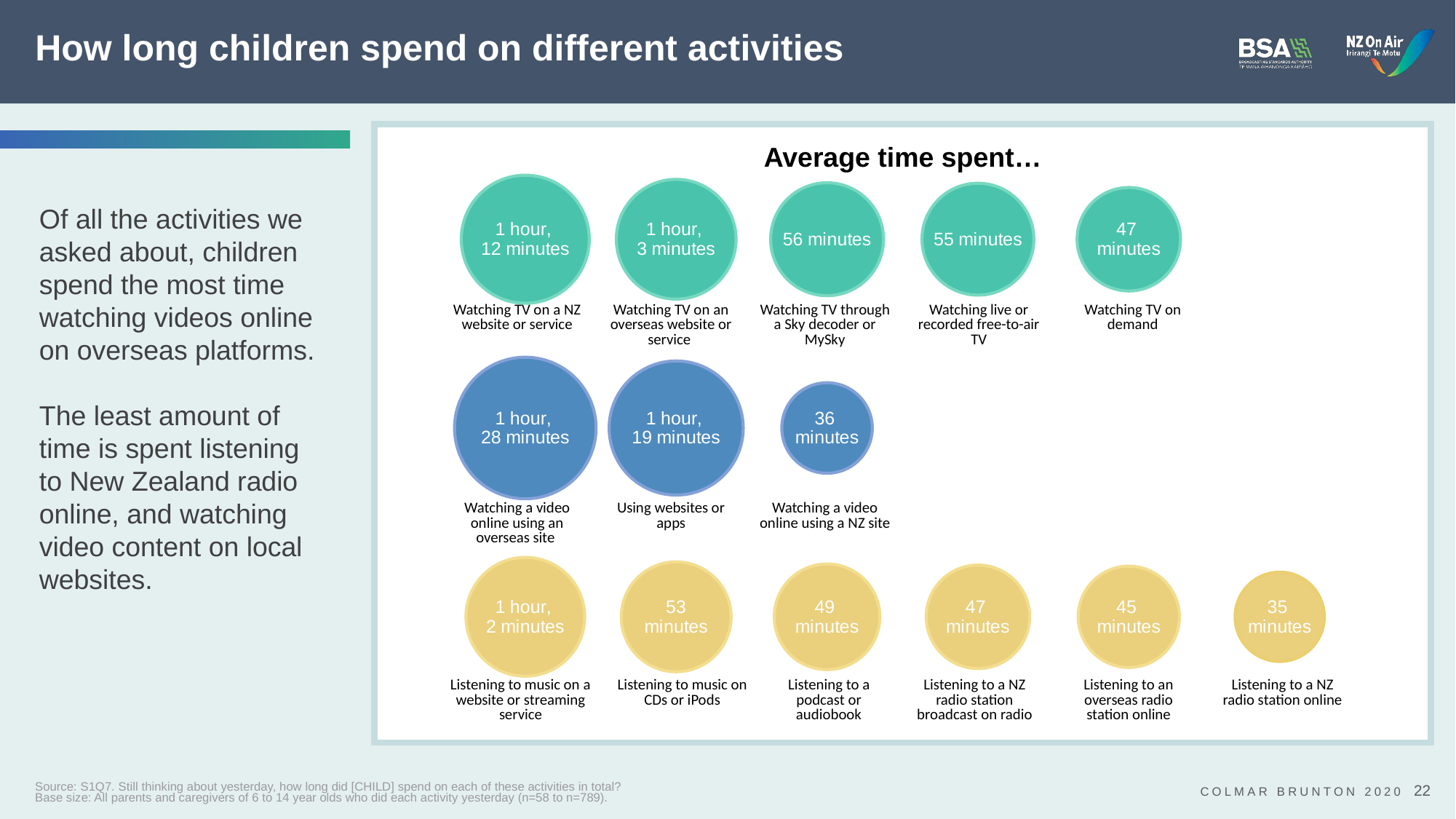
How much longer is the average time spent watching a video online using an overseas site than using websites or apps? 9 minutes Which activity has the highest average time spent? Watching a video online using an overseas site What is the average time spent watching TV through a Sky decoder or MySky? 56 minutes What is the average time spent listening to a NZ radio station online? 35 minutes What is the difference between the average time spent listening to music on CDs or iPods and listening to a podcast or audiobook? 4 minutes Which has a higher average time spent: watching TV on a NZ website or service, or watching TV on an overseas website or service? Watching TV on a NZ website or service What is the title of the chart? Average time spent… How many activities are shown in the chart? 14 What is the average time spent watching a video online using an overseas site? 1 hour, 28 minutes Which activity has the lowest average time spent? Listening to a NZ radio station online What is the average time spent listening to music on CDs or iPods? 53 minutes What kind of chart is used to show the average time spent? Bubble chart